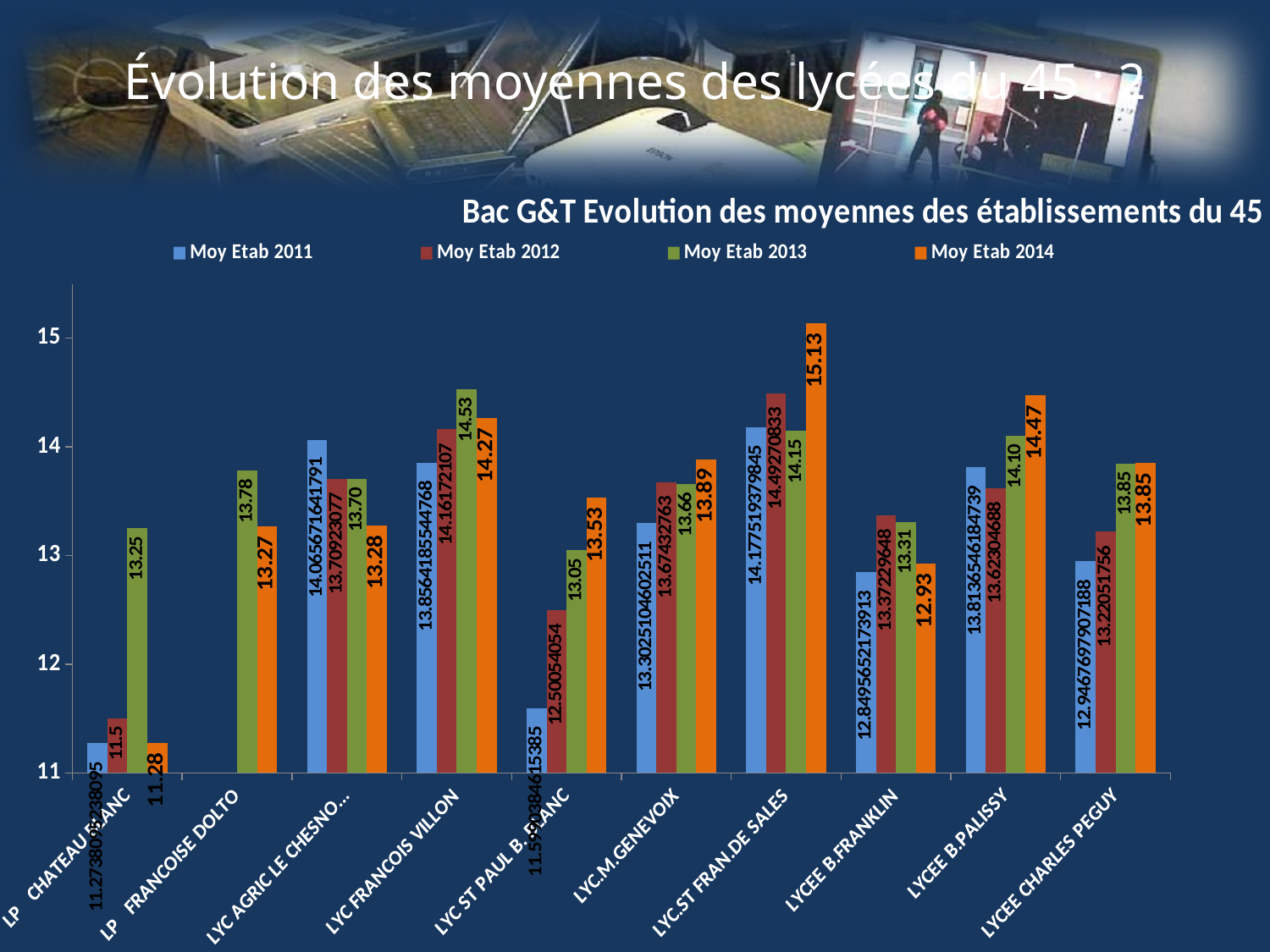
Which establishment has the highest Moy Etab 2014 value? LYC.ST FRAN.DE SALES How many establishments (categories) are shown on the x axis? 10 Is the Moy Etab 2011 value for LYC AGRIC LE CHESNO... greater or less than 14? greater Which is larger for LYC.M.GENEVOIX: the Moy Etab 2013 value or the Moy Etab 2014 value? Moy Etab 2014 Do the values for LYC ST PAUL B.BLANC rise or fall from Moy Etab 2011 to Moy Etab 2014? rise What type of chart is shown on the slide? bar chart What is the Moy Etab 2014 value for LYC.ST FRAN.DE SALES? 15.13 How many series does the legend list? 4 Which establishment has the lowest Moy Etab 2014 value? LP CHATEAU BLANC What is the difference between the Moy Etab 2014 values of LYCEE B.PALISSY and LYC FRANCOIS VILLON? 0.20 What is the Moy Etab 2013 value for LYC FRANCOIS VILLON? 14.53 What is the Moy Etab 2014 value for LYCEE B.FRANKLIN? 12.93